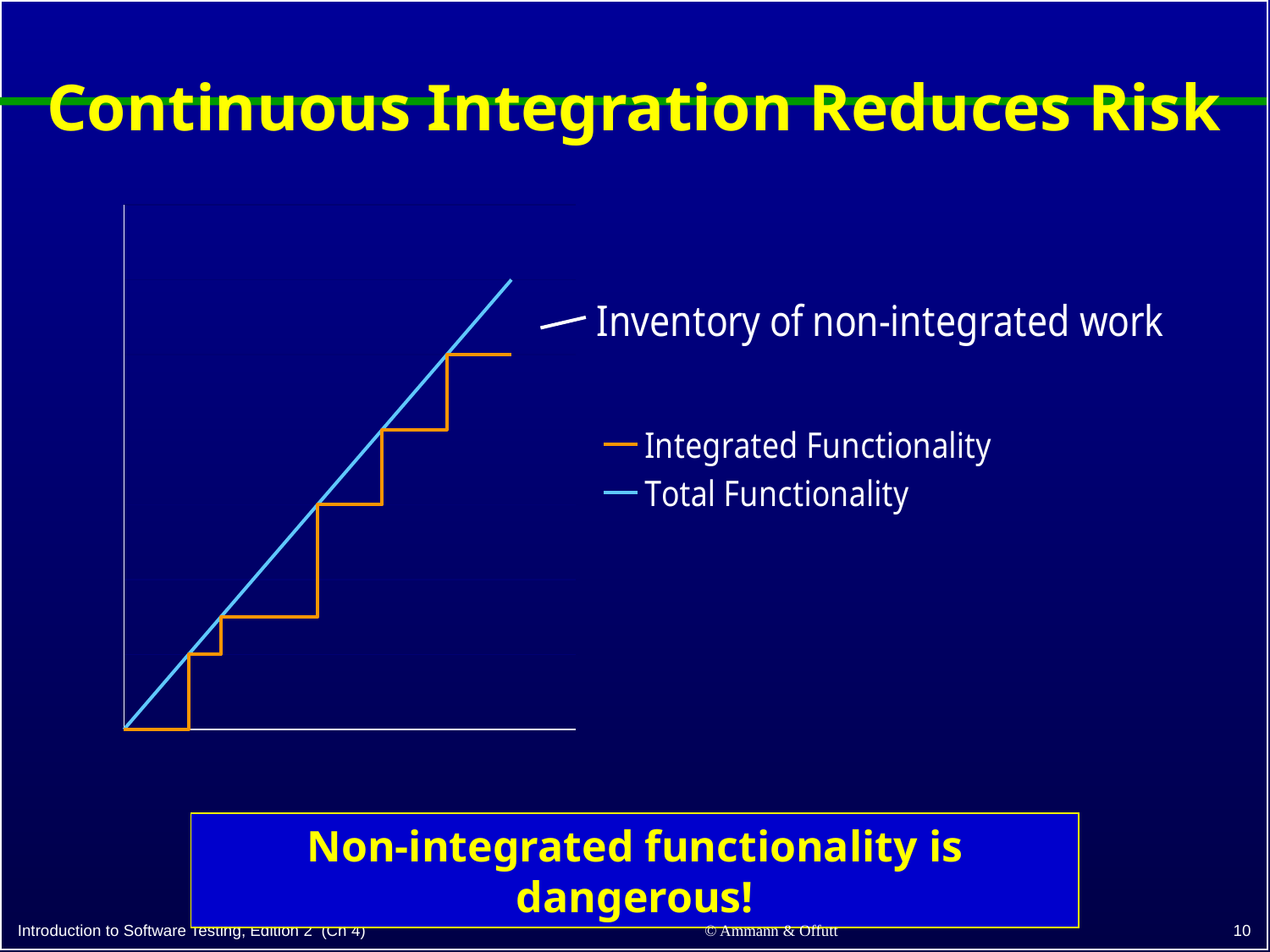
How many series does the chart's legend list? 2 Which series is drawn in orange in the chart? Integrated Functionality What does the annotation pointing at the gap between the two lines say? Inventory of non-integrated work Do the values of the Integrated Functionality series rise or fall along the x axis? rise What kind of chart is shown on the slide? line chart Do the values of the Total Functionality series rise or fall along the x axis? rise